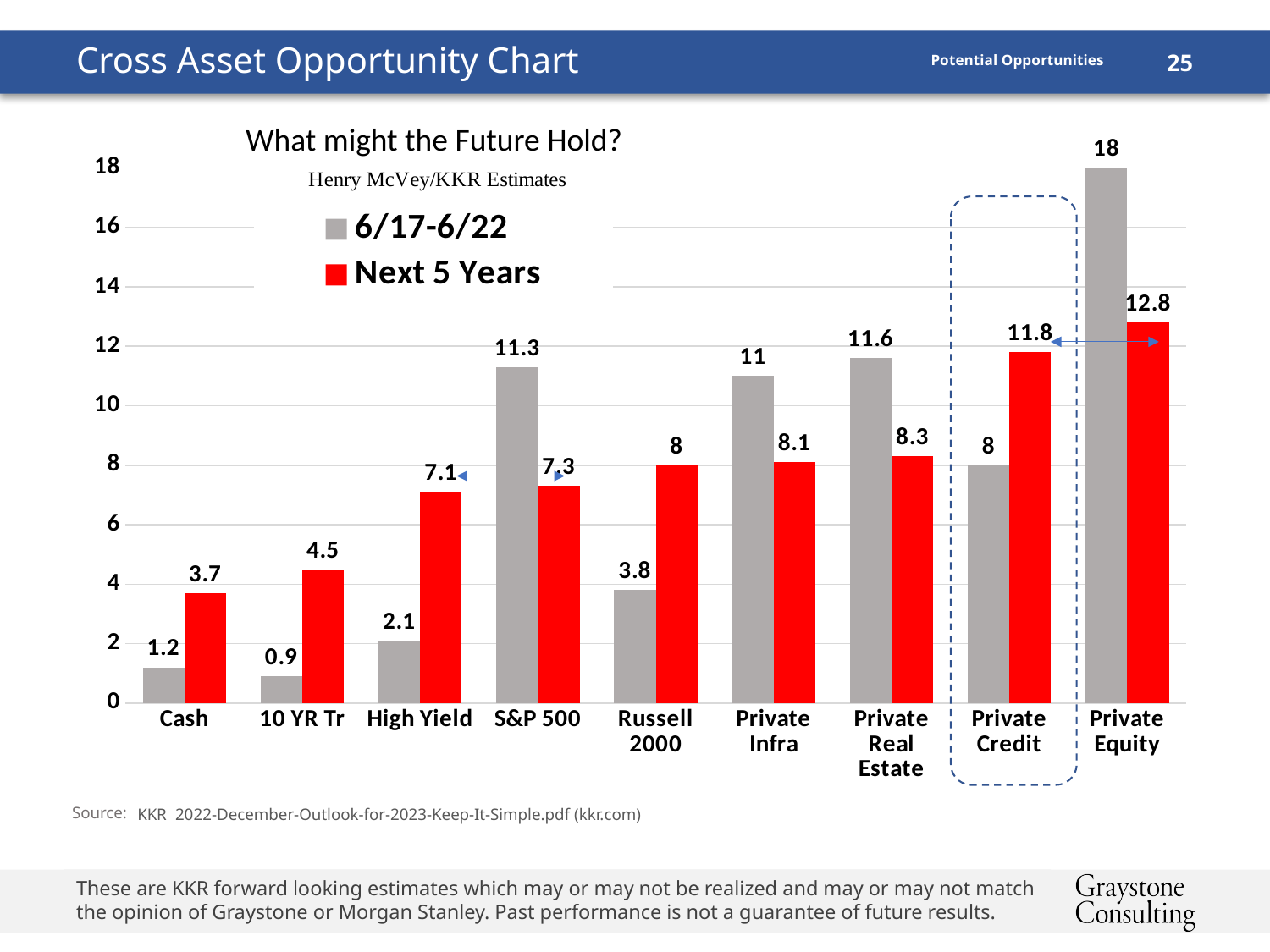
What is the 6/17-6/22 value for S&P 500? 11.3 What is the difference between the 6/17-6/22 and Next 5 Years values for Private Equity? 5.2 What colour represents the Next 5 Years series? Red What is the Next 5 Years value for Private Credit? 11.8 How many series does the legend list? 2 Which category has the lowest 6/17-6/22 value? 10 YR Tr Which is larger for S&P 500: the 6/17-6/22 value or the Next 5 Years value? 6/17-6/22 Which category has the lowest Next 5 Years value? Cash Which category has the highest 6/17-6/22 value? Private Equity What kind of chart is shown on the slide? Bar chart How many categories are shown on the x axis? 9 What is the Next 5 Years value for High Yield? 7.1